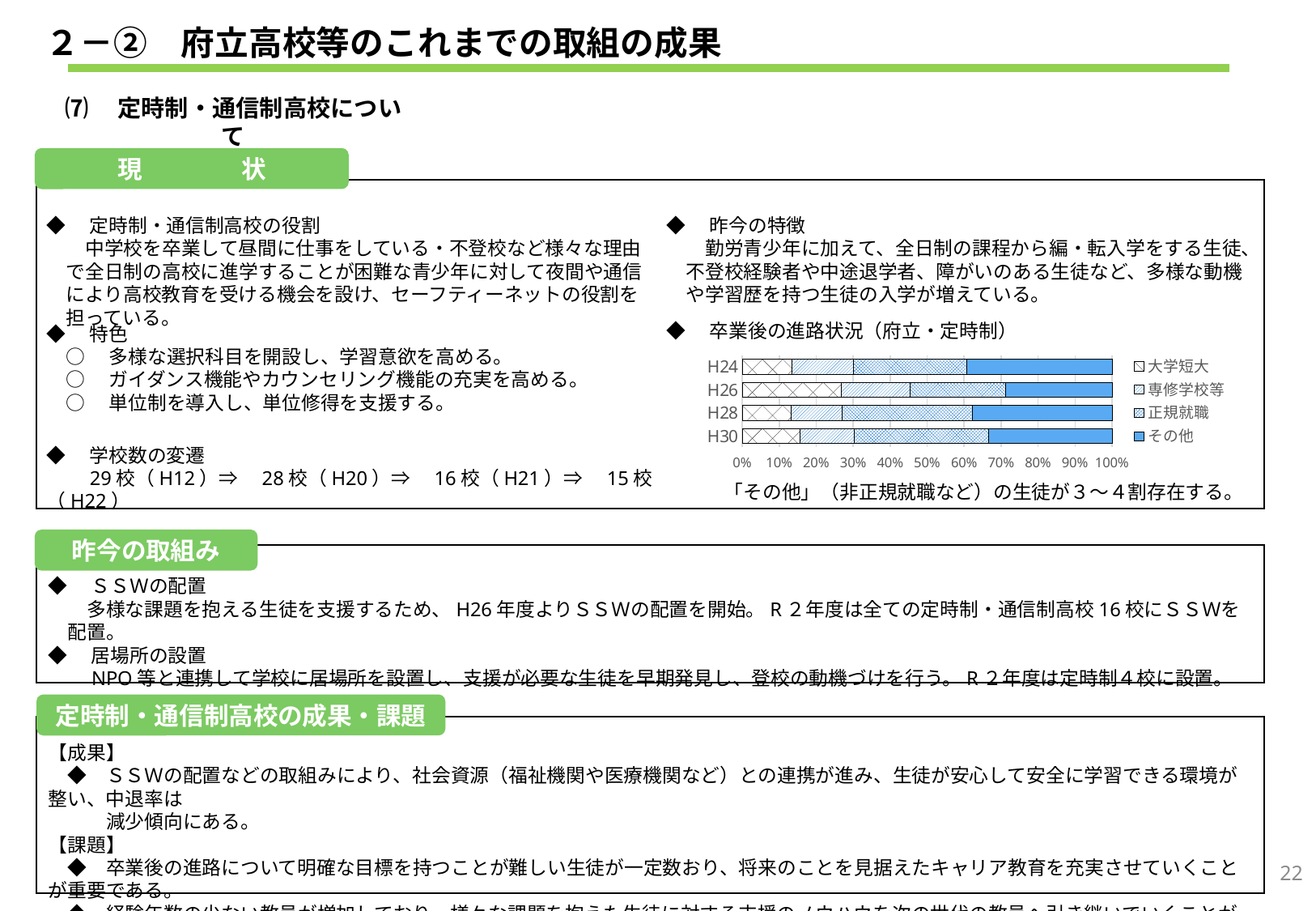
In the 卒業後の進路状況 chart, is the 大学短大 share for H26 greater or less than 20%? greater In the 卒業後の進路状況 chart, which year has the largest 大学短大 share? H26 In the 卒業後の進路状況 chart, is the 大学短大 share for H24 greater or less than 20%? less In the 卒業後の進路状況 chart, is the その他 share for H26 greater or less than 40%? less How many series does the legend of the 卒業後の進路状況 chart list? 4 In the 卒業後の進路状況 chart, is the 大学短大 share larger for H24 or for H26? H26 Which category is listed last in the legend of the 卒業後の進路状況 chart? その他 What kind of chart is used to show 卒業後の進路状況（府立・定時制）? stacked bar chart How many years (categories) are shown in the 卒業後の進路状況 chart? 4 What is the highest tick value shown on the horizontal axis of the 卒業後の進路状況 chart? 100% Which category is listed first in the legend of the 卒業後の進路状況 chart? 大学短大